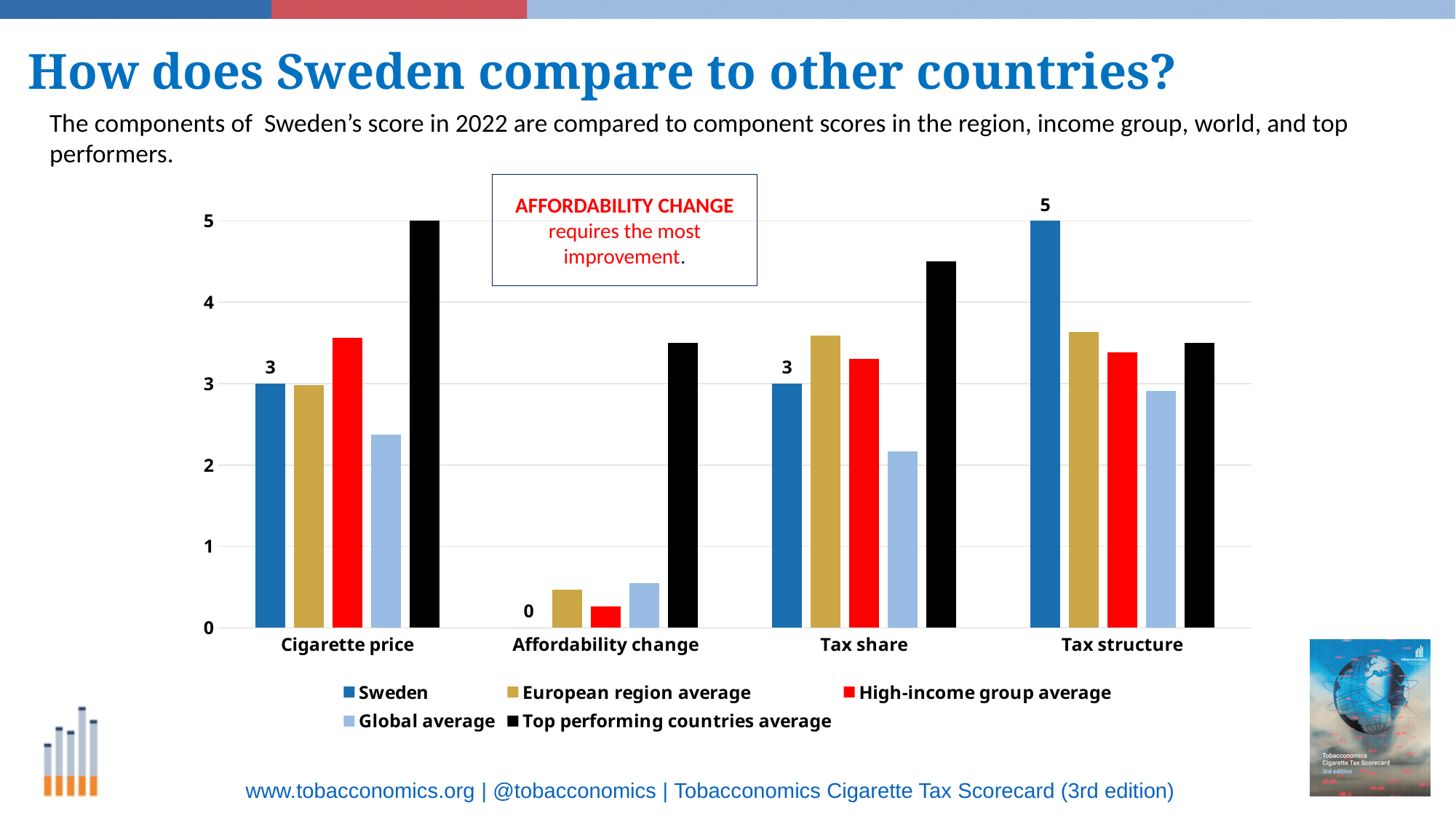
What is the value for Sweden in the Cigarette price category? 3 What is the value for Sweden in the Affordability change category? 0 Which is larger for Sweden: the Tax share score or the Tax structure score? Tax structure What is the difference between Sweden's Tax structure score and its Cigarette price score? 2 What is the value for Sweden in the Tax structure category? 5 What kind of chart is shown on the slide? bar chart How many categories are shown on the x axis of the chart? 4 Is the Global average for Cigarette price greater or less than 3? less In which category does Sweden have its lowest score? Affordability change In which category does Sweden have its highest score? Tax structure How many series does the legend list? 5 Is the Top performing countries average for Tax share greater or less than 4? greater